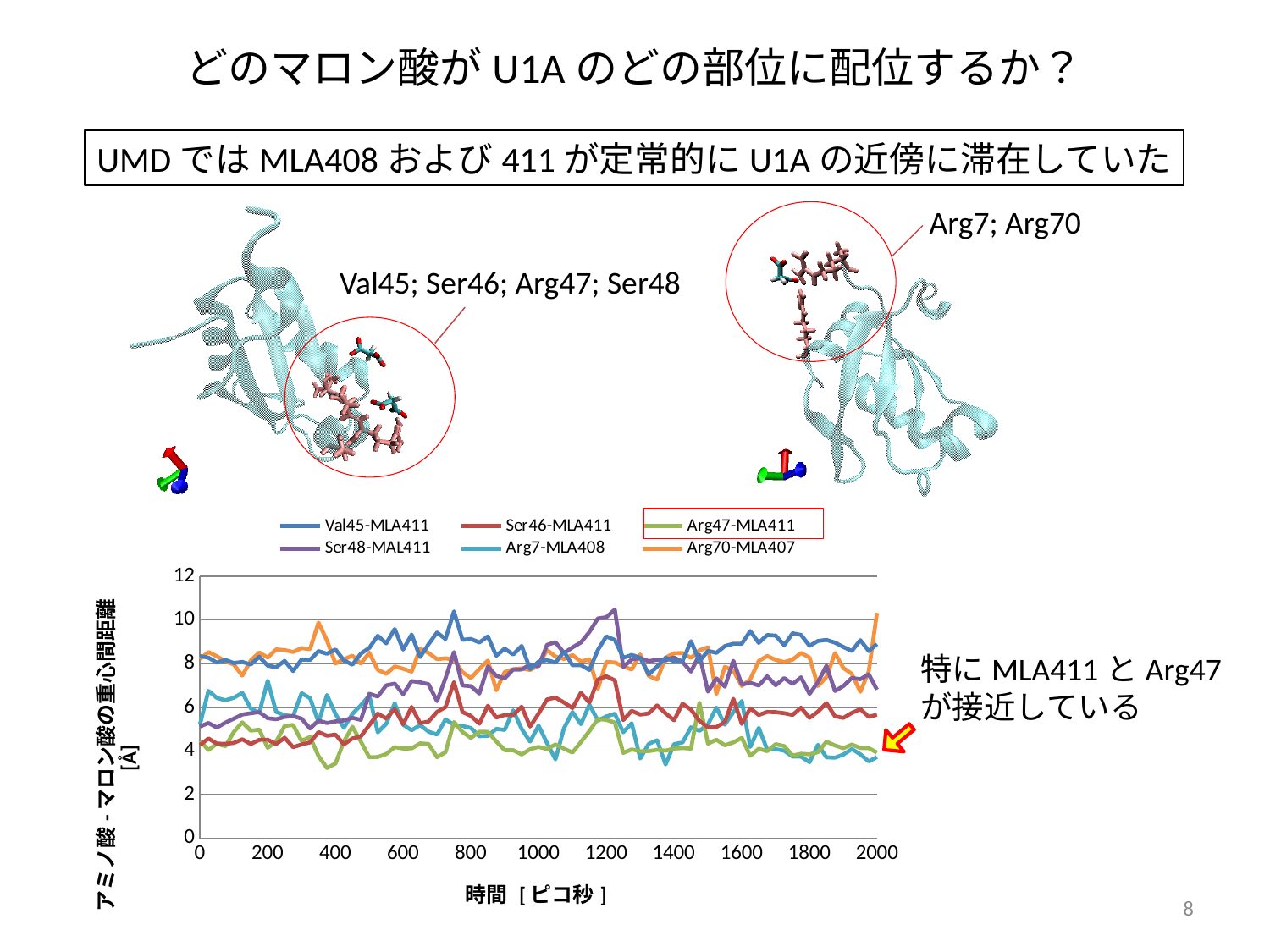
What kind of chart is shown on the slide? line chart Which series is highlighted with a red box in the chart legend? Arg47-MLA411 Is the value for Arg47-MLA411 at time 2000 greater or less than 6? less How many series does the legend of the chart list? 6 Is the value for Ser48-MAL411 at time 1200 greater or less than 8? greater Which series has the highest value at time 1200? Ser48-MAL411 At time 2000, which is larger: the value for Val45-MLA411 or the value for Ser46-MLA411? Val45-MLA411 Is the value for Ser46-MLA411 at time 0 greater or less than 6? less Which series has the highest value at time 2000? Arg70-MLA407 What is the x-axis label of the chart? 時間 [ピコ秒]